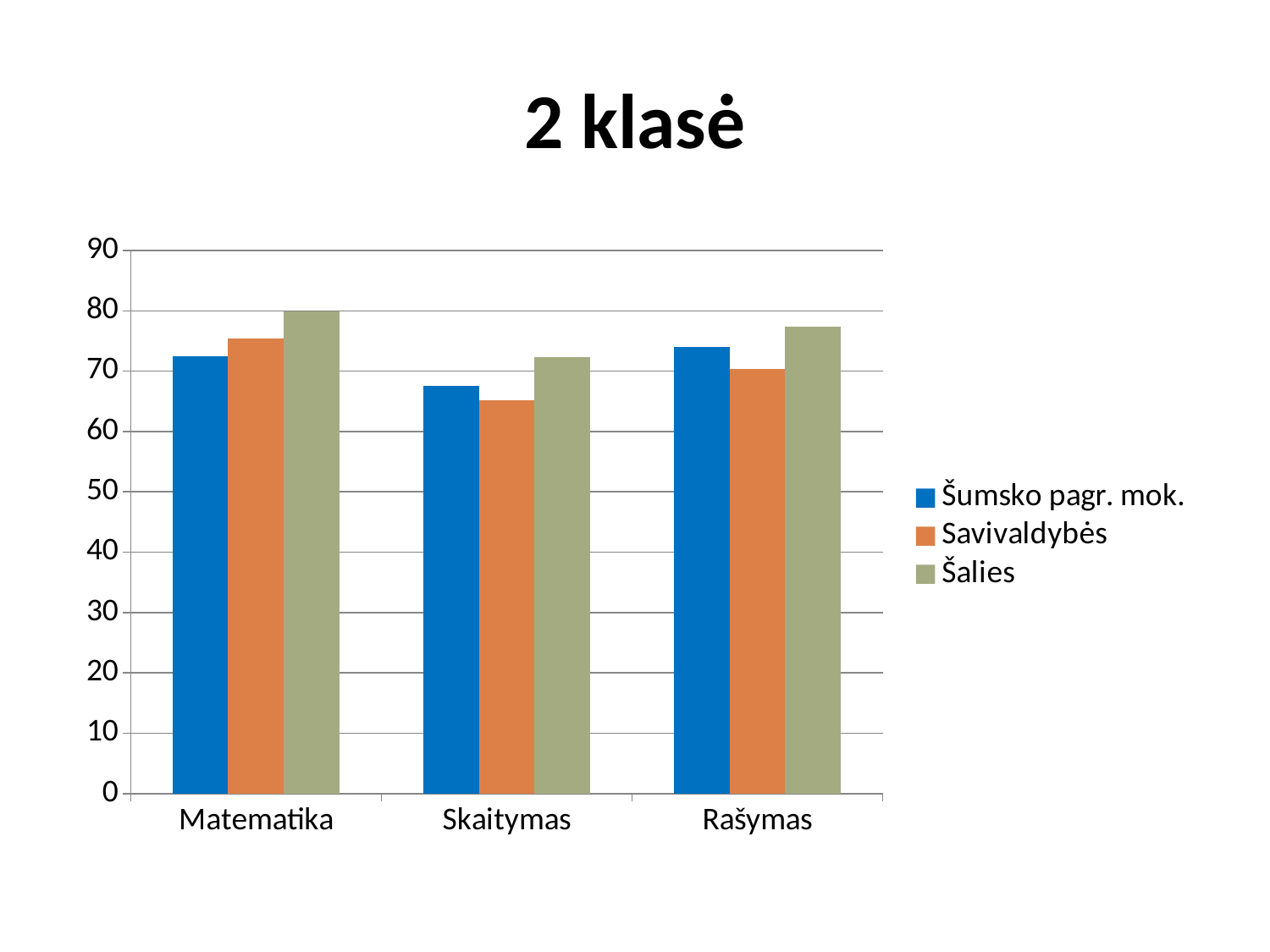
Which series is shown in blue in the legend? Šumsko pagr. mok. How many series does the legend list? 3 What kind of chart is shown on the slide? bar chart Which category has the highest value for the Šalies series? Matematika Is the value for Šalies in Rašymas greater or less than 70? greater Is the value for Savivaldybės in Skaitymas greater or less than 70? less Which category has the lowest value for the Savivaldybės series? Skaitymas How many categories are shown on the x axis? 3 Which category has the lowest value for the Šumsko pagr. mok. series? Skaitymas What is the title of the chart? 2 klasė For Skaitymas, which is larger: Šumsko pagr. mok. or Savivaldybės? Šumsko pagr. mok. For Matematika, which is larger: Šumsko pagr. mok. or Šalies? Šalies